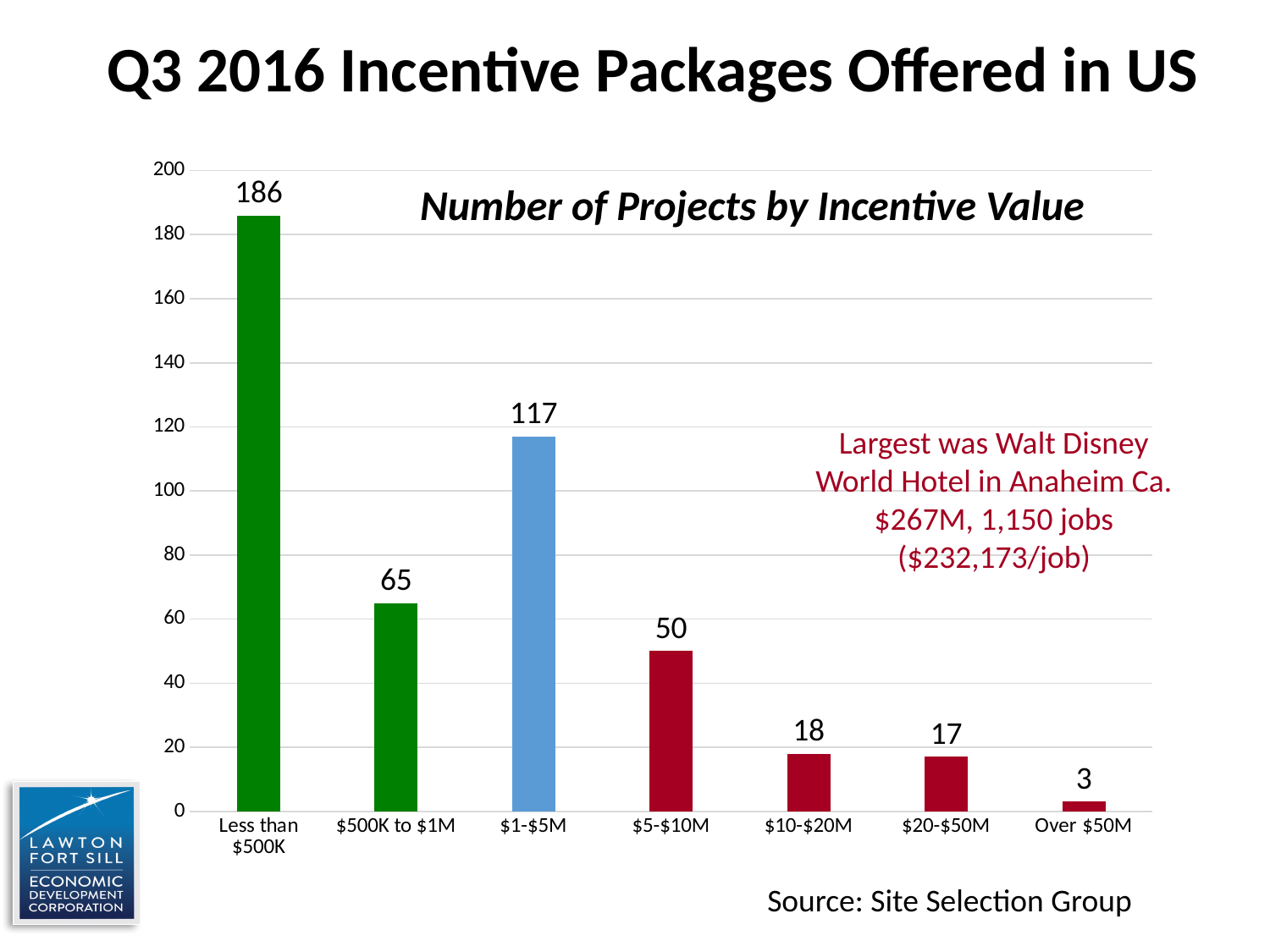
What is the title of the chart? Number of Projects by Incentive Value Which category has more projects, $10-$20M or $20-$50M? $10-$20M What type of chart is used to show the number of projects by incentive value? Bar chart Which incentive value category has the lowest number of projects? Over $50M How many incentive value categories are shown on the chart? 7 Which incentive value category has the highest number of projects? Less than $500K How many projects had an incentive value of less than $500K? 186 What is the number of projects in the $1-$5M incentive value category? 117 What is the difference in the number of projects between the Less than $500K and $1-$5M categories? 69 Is the number of projects in the $500K to $1M category greater or less than 80? less How many projects are shown for the $5-$10M category? 50 What is the difference in the number of projects between the $500K to $1M and $5-$10M categories? 15